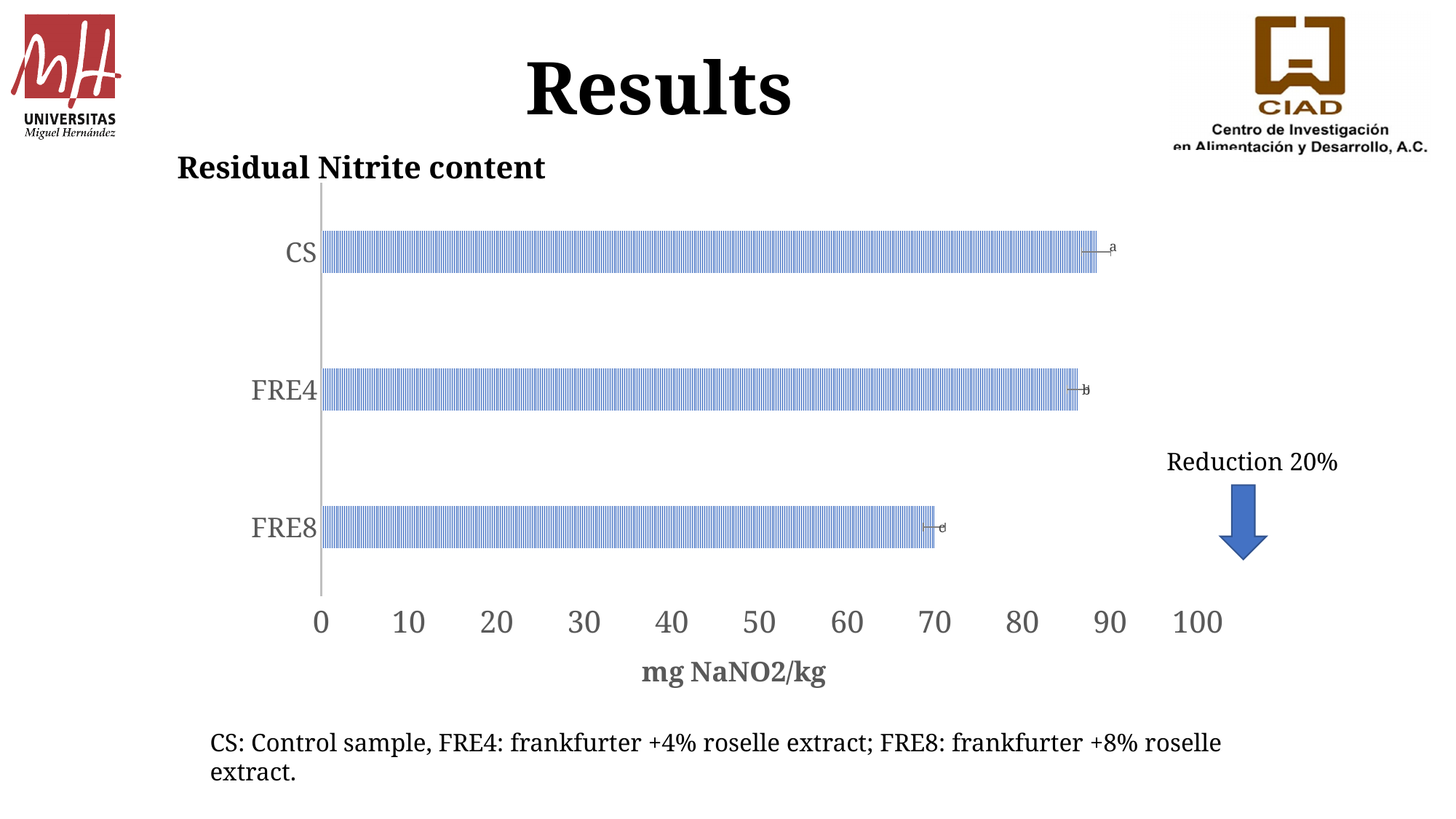
How many categories (samples) are plotted in the Residual Nitrite content chart? 3 What unit is shown on the horizontal axis of the chart? mg NaNO2/kg Which sample has the lowest residual nitrite content? FRE8 Is the residual nitrite content for FRE8 greater or less than 80? less Is the residual nitrite content for FRE4 greater or less than 80? greater Is the residual nitrite content for FRE8 greater or less than 60? greater Which has a higher residual nitrite content, CS or FRE8? CS What is the title of the chart? Residual Nitrite content Which has a lower residual nitrite content, FRE4 or FRE8? FRE8 What kind of chart is shown on the slide? bar chart